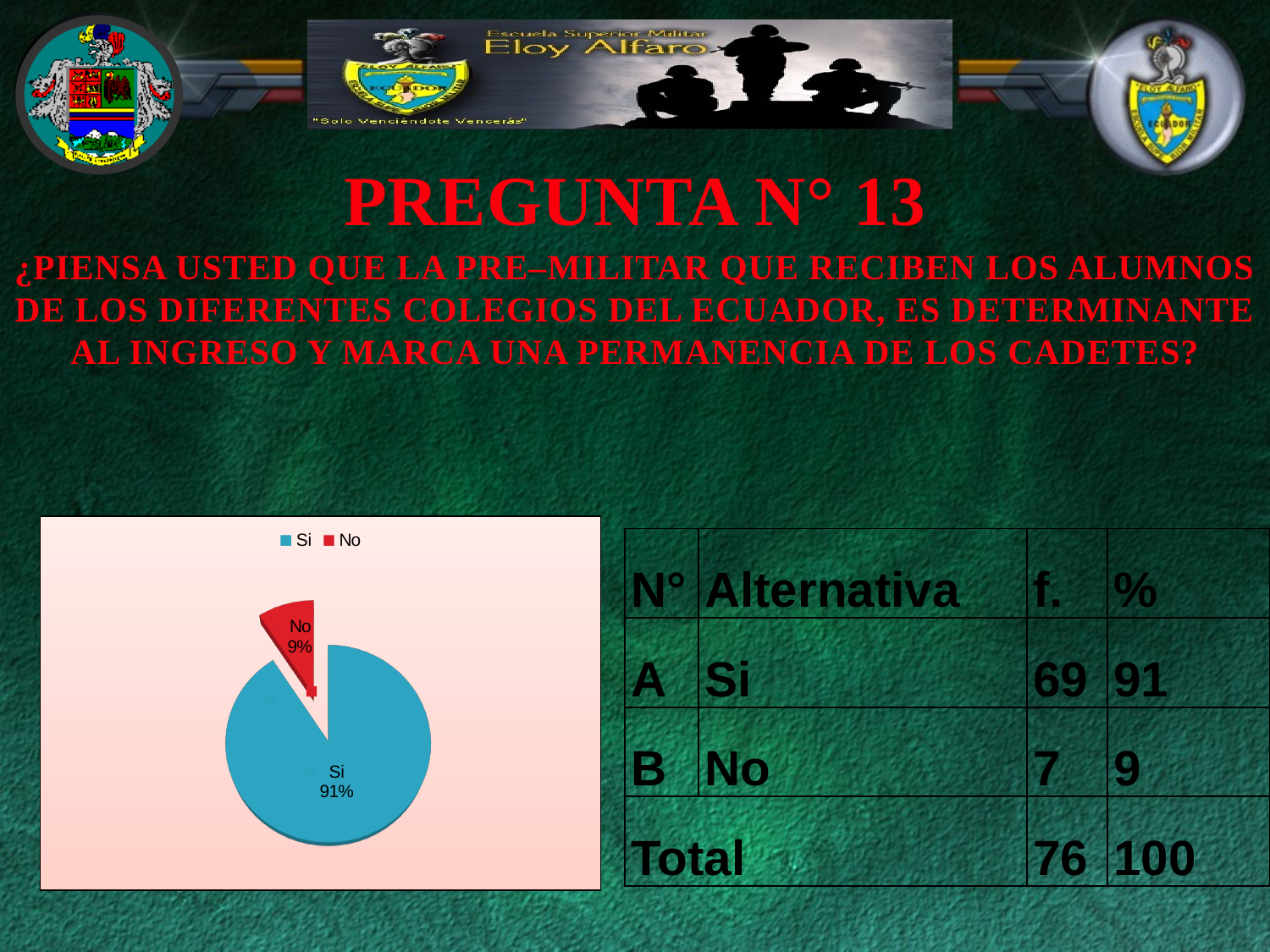
Which slice of the pie chart is the smallest? No What kind of chart is shown on the slide? pie chart What is the difference in percentage points between the "Si" and "No" slices of the pie chart? 82 What colour is the "No" slice in the pie chart? red What colour is the "Si" slice in the pie chart? blue How many entries does the legend of the pie chart list? 2 What share of the pie chart does the "No" slice represent? 9% What percentage of the pie chart is labelled "No"? 9% Which is larger in the pie chart, the "Si" slice or the "No" slice? Si How many slices does the pie chart have? 2 What percentage of the pie chart is labelled "Si"? 91% Which slice of the pie chart is the largest? Si